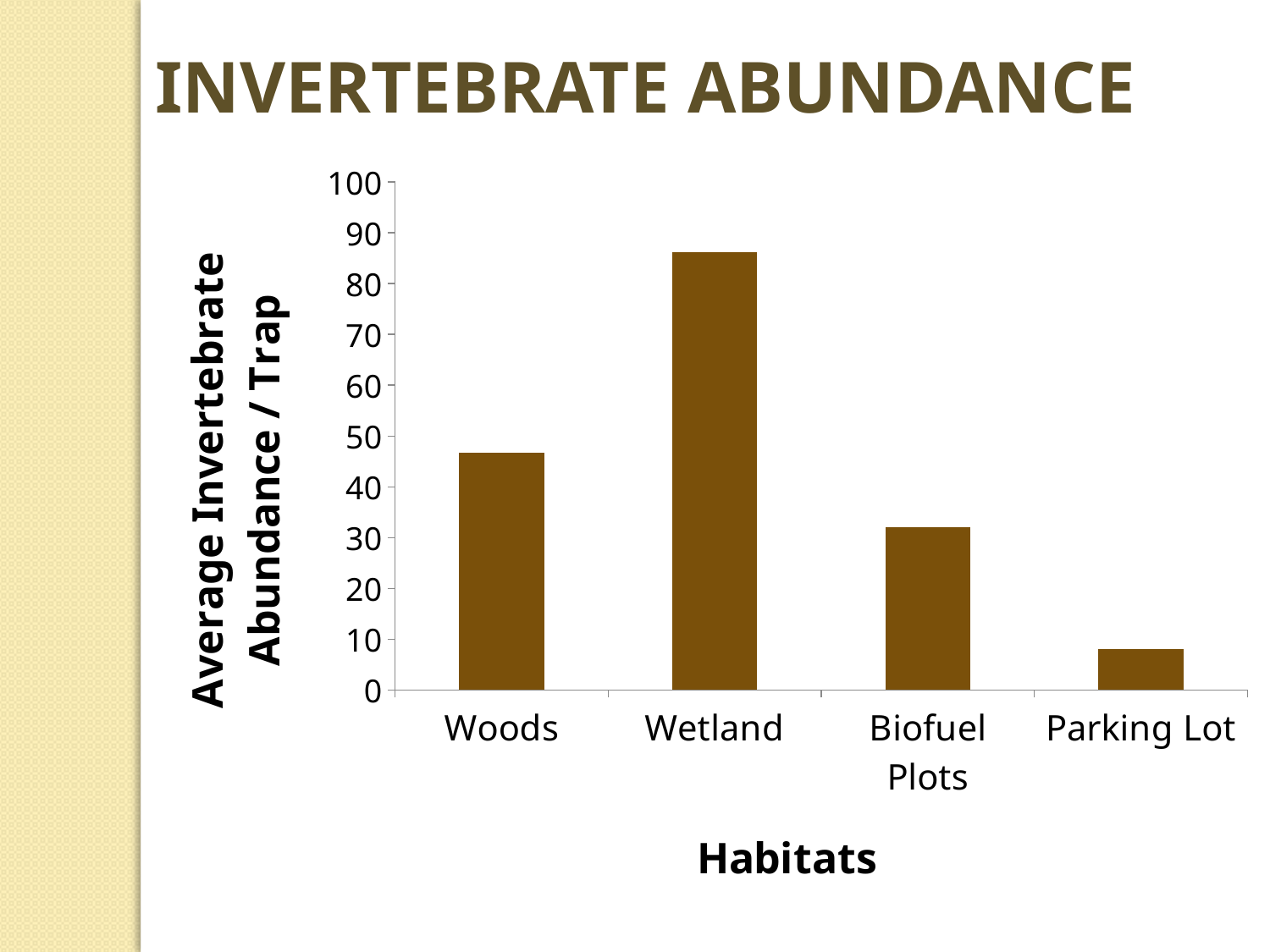
Is the average invertebrate abundance per trap for Wetland greater or less than 80? greater Is the average invertebrate abundance per trap for Wetland greater or less than 90? less Which habitat has the highest average invertebrate abundance per trap? Wetland Is the average invertebrate abundance per trap for Biofuel Plots greater or less than 40? less Which habitat has the lowest average invertebrate abundance per trap? Parking Lot What is the label of the y axis of the chart? Average Invertebrate Abundance / Trap Which has a higher average invertebrate abundance per trap, Woods or Biofuel Plots? Woods Which has a lower average invertebrate abundance per trap, Biofuel Plots or Parking Lot? Parking Lot What kind of chart is shown on the slide? Bar chart How many habitats are shown on the x axis of the chart? 4